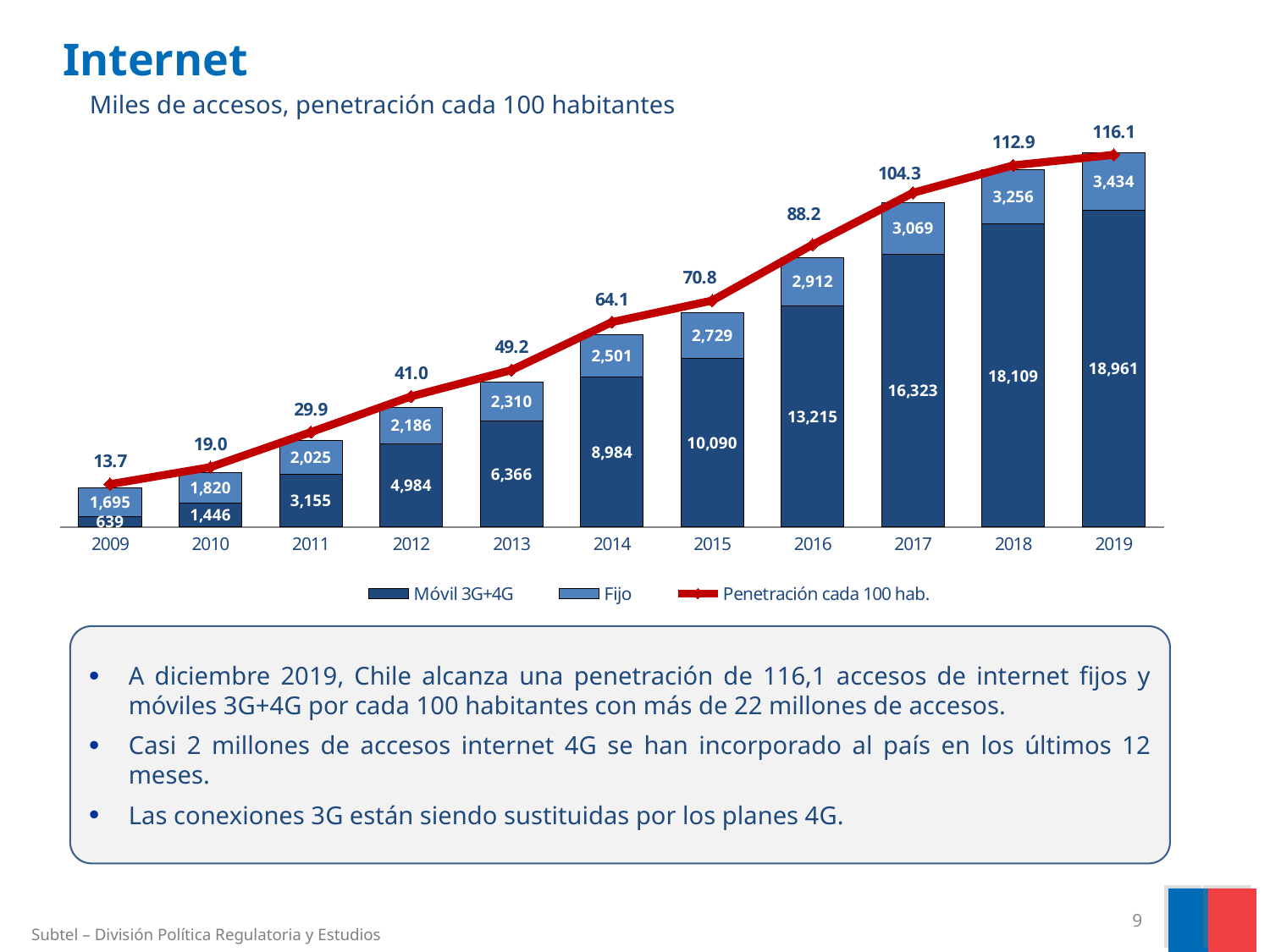
What is the Penetración cada 100 hab. value for 2016? 88.2 What is the difference between the Móvil 3G+4G values for 2019 and 2018? 852 How many series does the legend list? 3 Which is larger in 2010: Móvil 3G+4G or Fijo? Fijo What kind of chart is this? Stacked bar chart with a line How many years are shown on the x axis? 11 Which year has the highest Penetración cada 100 hab. value? 2019 What is the value of Fijo in 2014? 2,501 Does the Penetración cada 100 hab. line rise or fall from 2009 to 2019? Rise What is the total of the stacked bar for 2017 (Móvil 3G+4G plus Fijo)? 19,392 What is the value of Móvil 3G+4G in 2019? 18,961 Which year has the lowest Móvil 3G+4G value? 2009